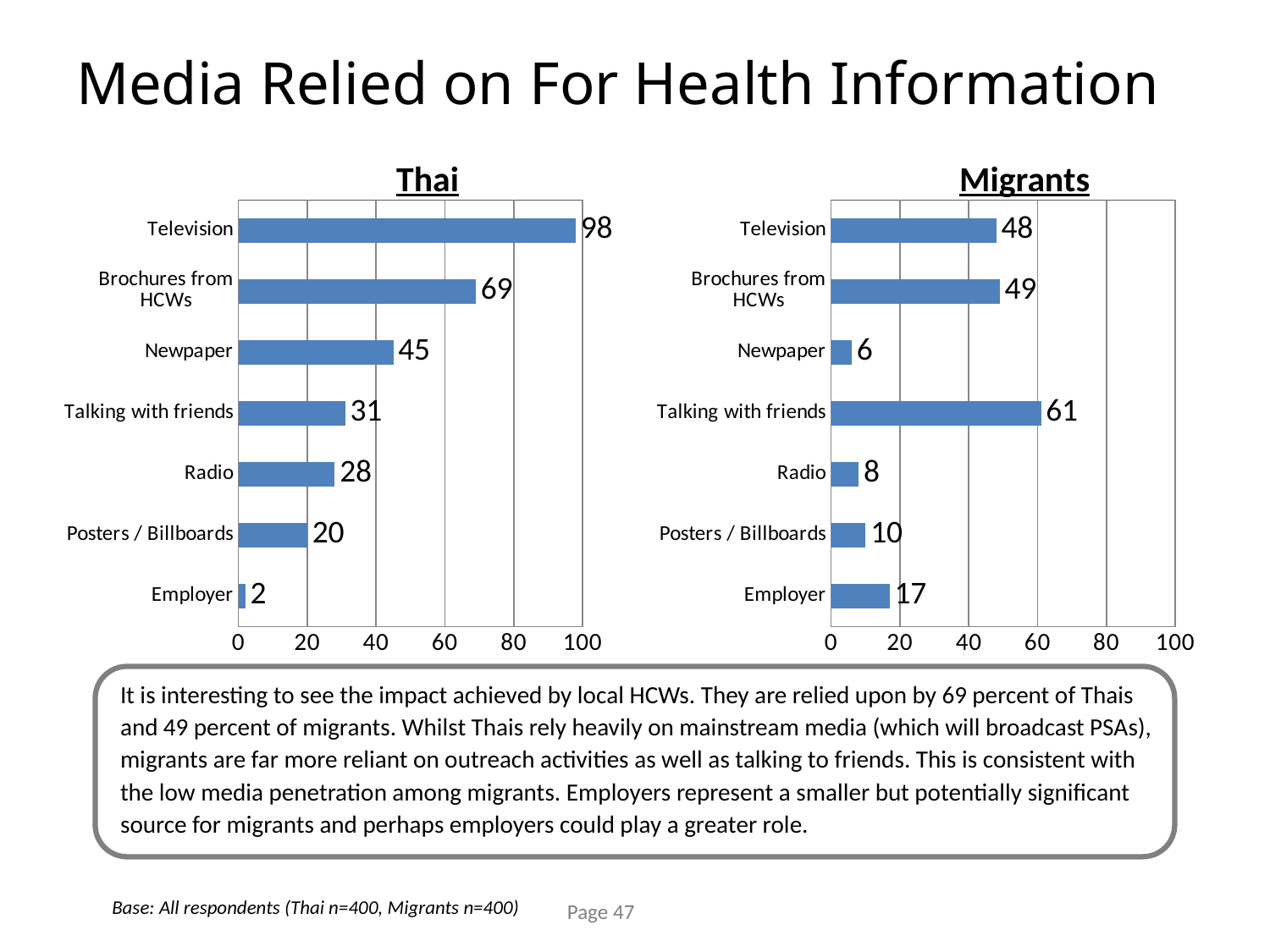
In the Thai chart, what is the value for Television? 98 Which is larger: the value for Radio in the Thai chart or the value for Radio in the Migrants chart? Thai In the Thai chart, what is the difference between the values for Television and Brochures from HCWs? 29 In the Migrants chart, what is the value for Employer? 17 In the Migrants chart, which category has the lowest value? Newpaper In the Thai chart, which category has the lowest value? Employer In the Migrants chart, what is the value for Talking with friends? 61 In the Migrants chart, which category has the highest value? Talking with friends What type of chart is the Migrants chart? Bar chart What is the title of the chart on the left? Thai How many categories are shown in the Thai chart? 7 In the Migrants chart, what is the difference between the values for Talking with friends and Television? 13